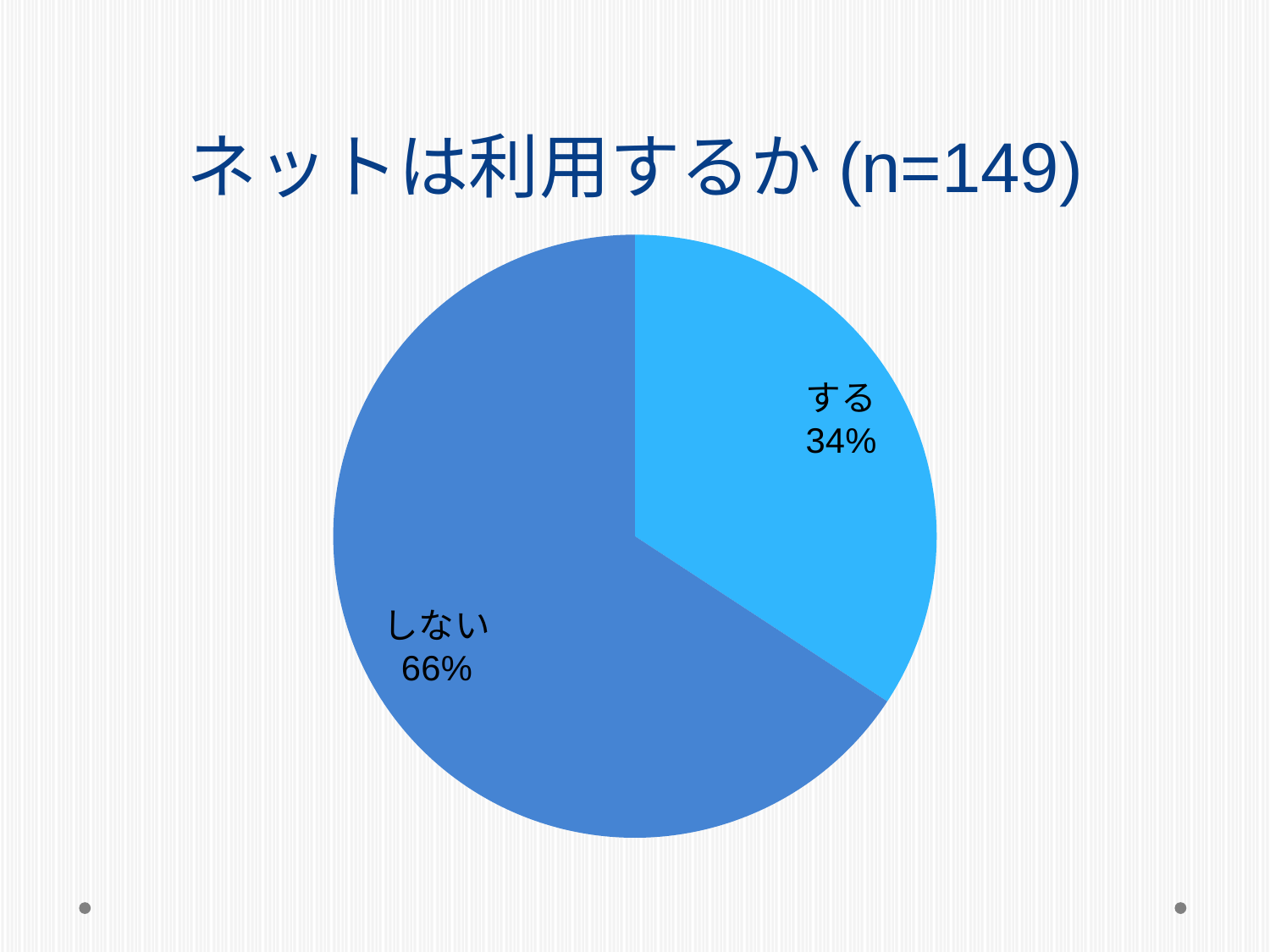
What is the sample size (n) shown in the chart title? 149 What is the title of the chart? ネットは利用するか (n=149) What share of the pie does する represent? 34% Which slice is the smallest? する How many slices does the pie chart have? 2 What share of the pie does しない represent? 66% What is the difference in percentage points between しない and する? 32 Which slice is the largest? しない Is the share for する greater or less than 50%? less What kind of chart is shown on the slide? pie chart Which is larger, する or しない? しない